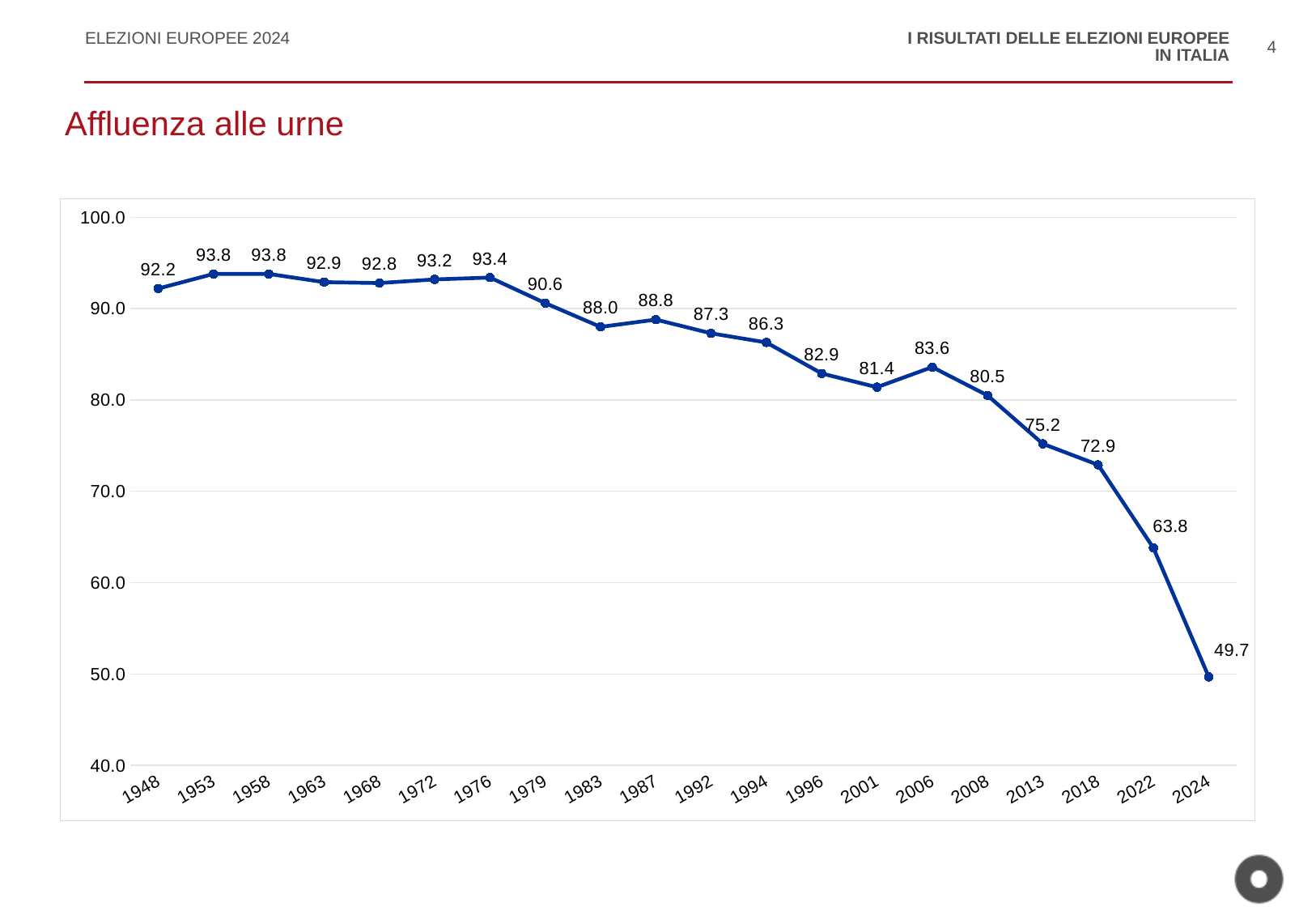
Do the values generally rise or fall from 1948 to 2024? fall What is the value for 1976? 93.4 How many data points are plotted on the chart? 20 What type of chart is shown on the slide? line chart What is the difference between the values for 1948 and 2018? 19.3 What is the difference between the values for 2022 and 2024? 14.1 What is the value for 2024? 49.7 Which year has the lowest value? 2024 What is the value for 2006? 83.6 Which is larger, the value for 2001 or the value for 2006? 2006 What is the title of the chart? Affluenza alle urne Which is larger, the value for 1983 or the value for 1987? 1987